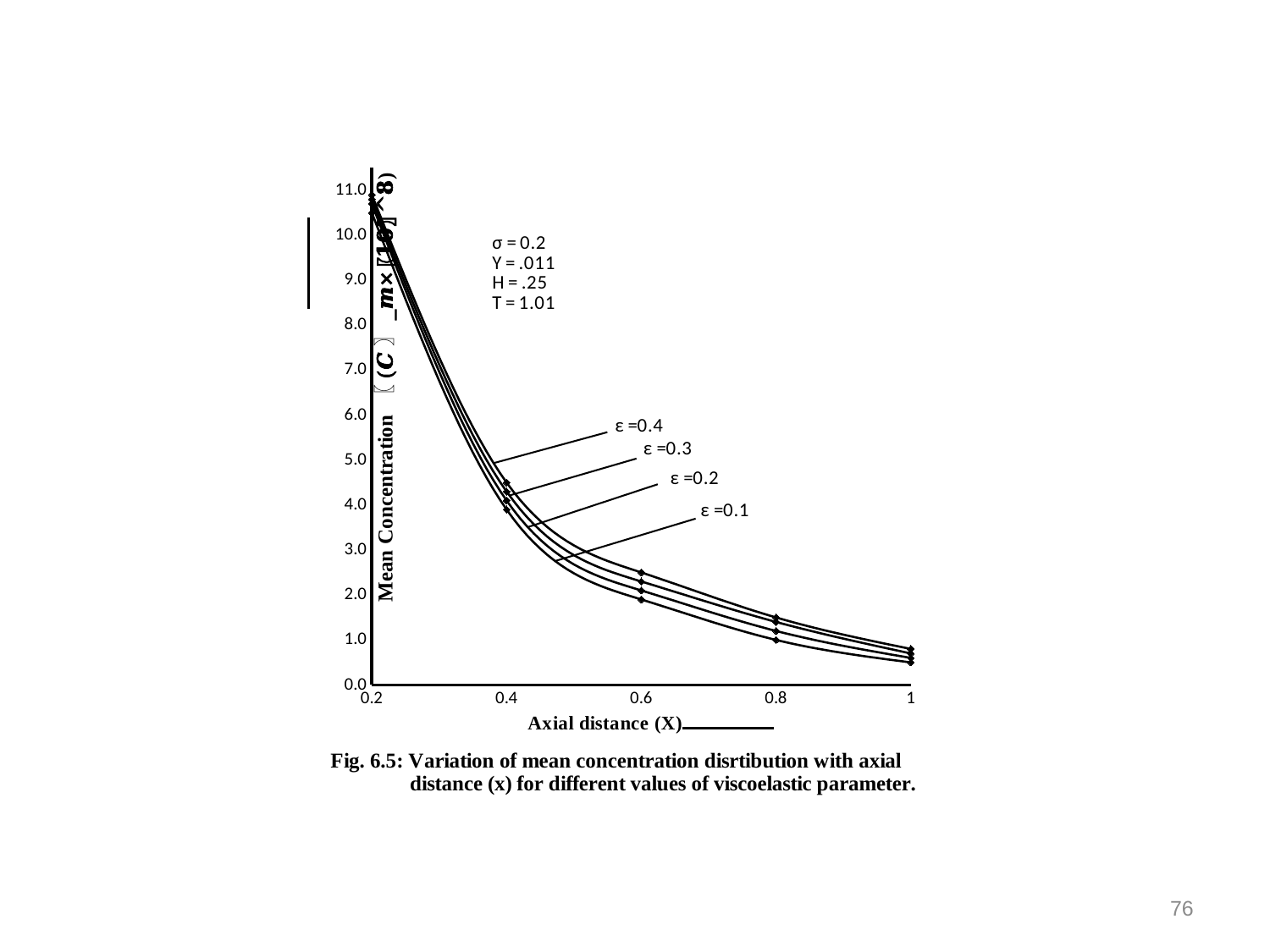
Is the mean concentration for ε =0.4 at X = 0.6 greater or less than 2.0? greater At X = 0.6, is the mean concentration larger for ε =0.4 or for ε =0.1? ε =0.4 What kind of chart is shown on the slide? line chart Is the mean concentration for ε =0.4 at X = 1 greater or less than 1.0? less Do the mean concentration values rise or fall as axial distance (X) increases? fall What is the title of the x axis of the chart? Axial distance (X) How many curves (values of ε) are plotted on the chart? 4 What value of σ is stated on the chart? 0.2 Which curve has the lowest mean concentration at X = 0.6? ε =0.1 Is the mean concentration for ε =0.4 at X = 0.4 greater or less than 4.0? greater Which curve has the highest mean concentration at X = 0.6? ε =0.4 How many x-axis tick values are shown on the chart? 5